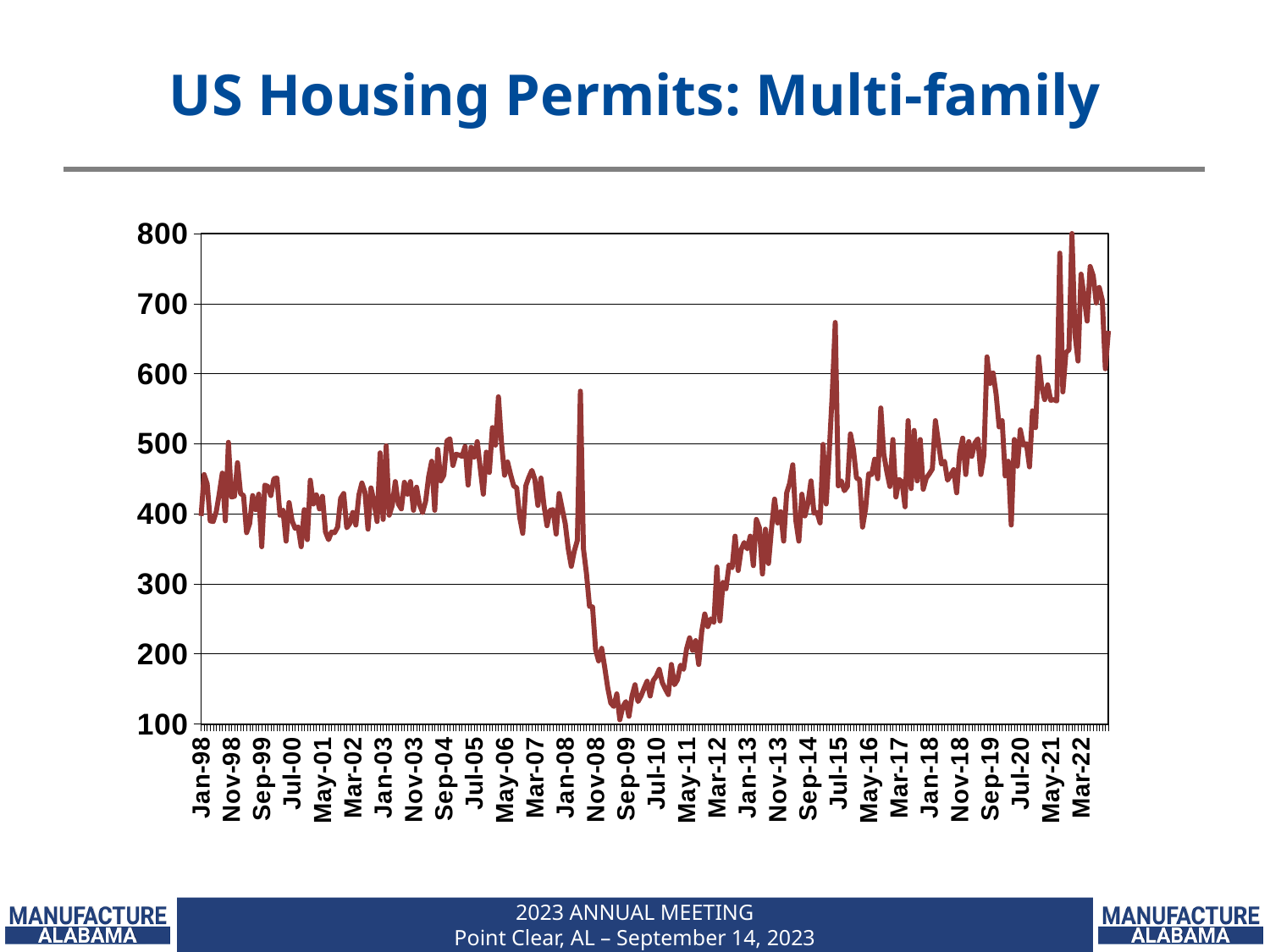
Is the value for Sep-09 greater or less than 200? less What kind of chart is shown on the slide? line chart Is the value for Jul-10 greater or less than 300? less How many lines are plotted on the chart? 1 Around which x-axis label does the line reach its lowest value? Sep-09 Do the values rise or fall between Jan-08 and Sep-09? fall Is the value for Sep-19 greater or less than 300? greater Do the values rise or fall between Sep-09 and Jul-15? rise What is the highest value shown on the y axis? 800 What is the title of the chart? US Housing Permits: Multi-family Which is larger, the value at Sep-09 or the value at Sep-19? Sep-19